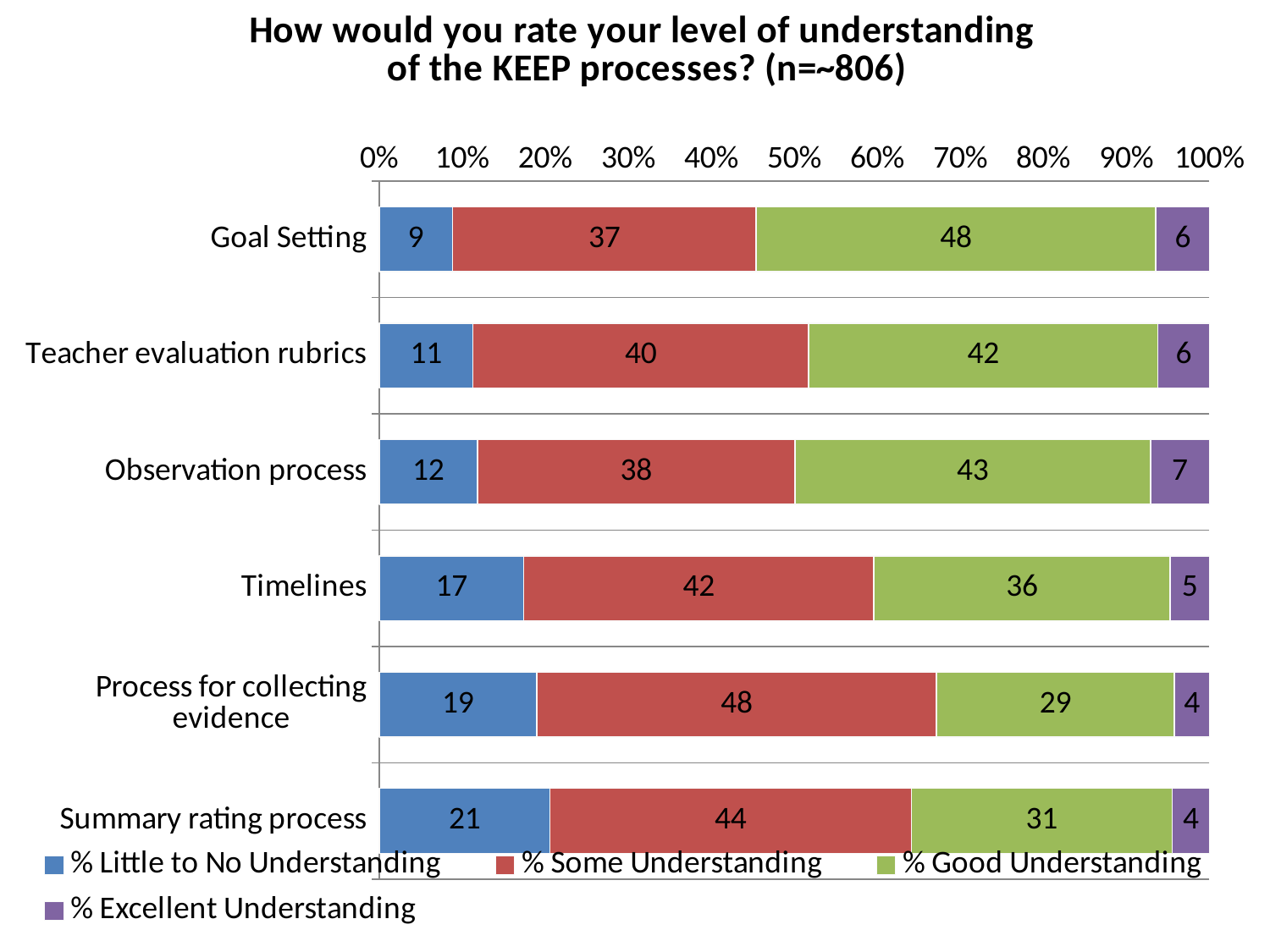
Which category has the lowest value for % Good Understanding? Process for collecting evidence Which category has the highest value for % Little to No Understanding? Summary rating process What kind of chart is shown on the slide? Stacked bar chart What colour represents % Excellent Understanding in the legend? Purple What is the value for % Excellent Understanding for Observation process? 7 How many categories are shown on the chart? 6 Which has the larger % Good Understanding value, Teacher evaluation rubrics or Observation process? Observation process What is the difference between the % Some Understanding values for Process for collecting evidence and Goal Setting? 11 How many series does the legend list? 4 What is the total of the four labelled segments for Teacher evaluation rubrics? 99 What is the value for % Little to No Understanding for Summary rating process? 21 What is the value for % Good Understanding for Goal Setting? 48